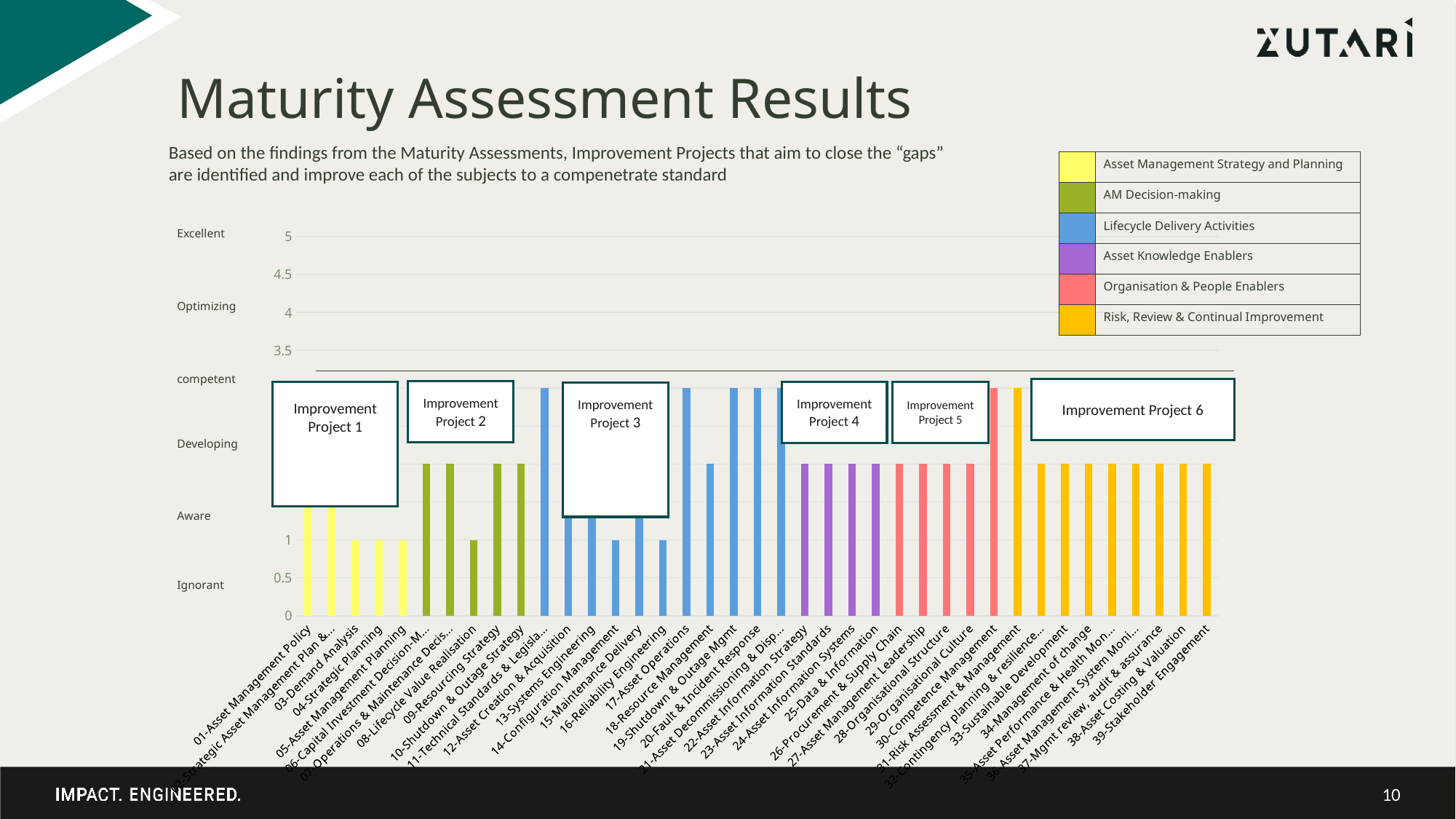
What is the difference between the value for 19-Shutdown & Outage Mgmt and the value for 16-Reliability Engineering? 2 Which colour does the legend assign to Lifecycle Delivery Activities? Blue What is the value for 17-Asset Operations? 3 What is the value for 03-Demand Analysis? 1 What kind of chart is shown on the slide? Bar chart What is the value for 08-Lifecycle Value Realisation? 1 Is the value for 11-Technical Standards & Legisla... greater or less than 2? greater What is the value for 30-Competence Management? 3 How many entries does the legend list? 6 How many categories (subjects) are plotted along the x axis? 39 What is the value for 22-Asset Information Strategy? 2 Which is larger, the value for 14-Configuration Management or the value for 18-Resource Management? 18-Resource Management